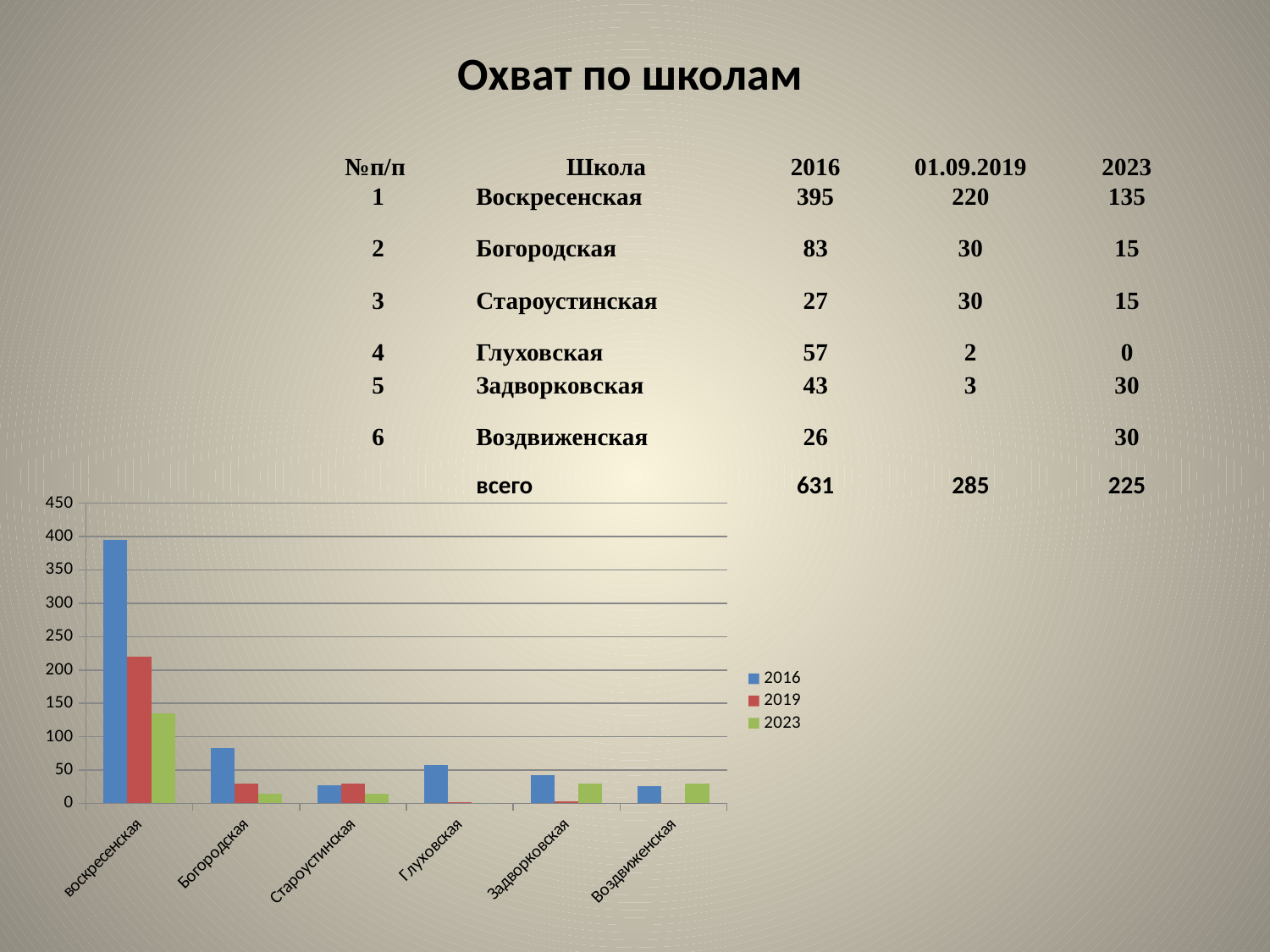
Do the values for Воскресенская rise or fall from 2016 to 2023? fall Is the 2019 value for Воскресенская greater or less than 200? greater Which school has the lowest value for 2023? Глуховская Is the 2016 value for Воскресенская greater or less than 350? greater What kind of chart is shown on the slide? bar chart What entries are listed in the chart legend? 2016, 2019, 2023 What is the value for Воскресенская in 2023? 135 How many series does the chart legend list? 3 Which school has the highest value for 2016 in the chart? Воскресенская What is the difference between the 2016 and 2023 values for Воскресенская? 260 How many schools are shown along the x axis of the chart? 6 Which is larger, the 2016 value for Богородская or the 2016 value for Глуховская? Богородская